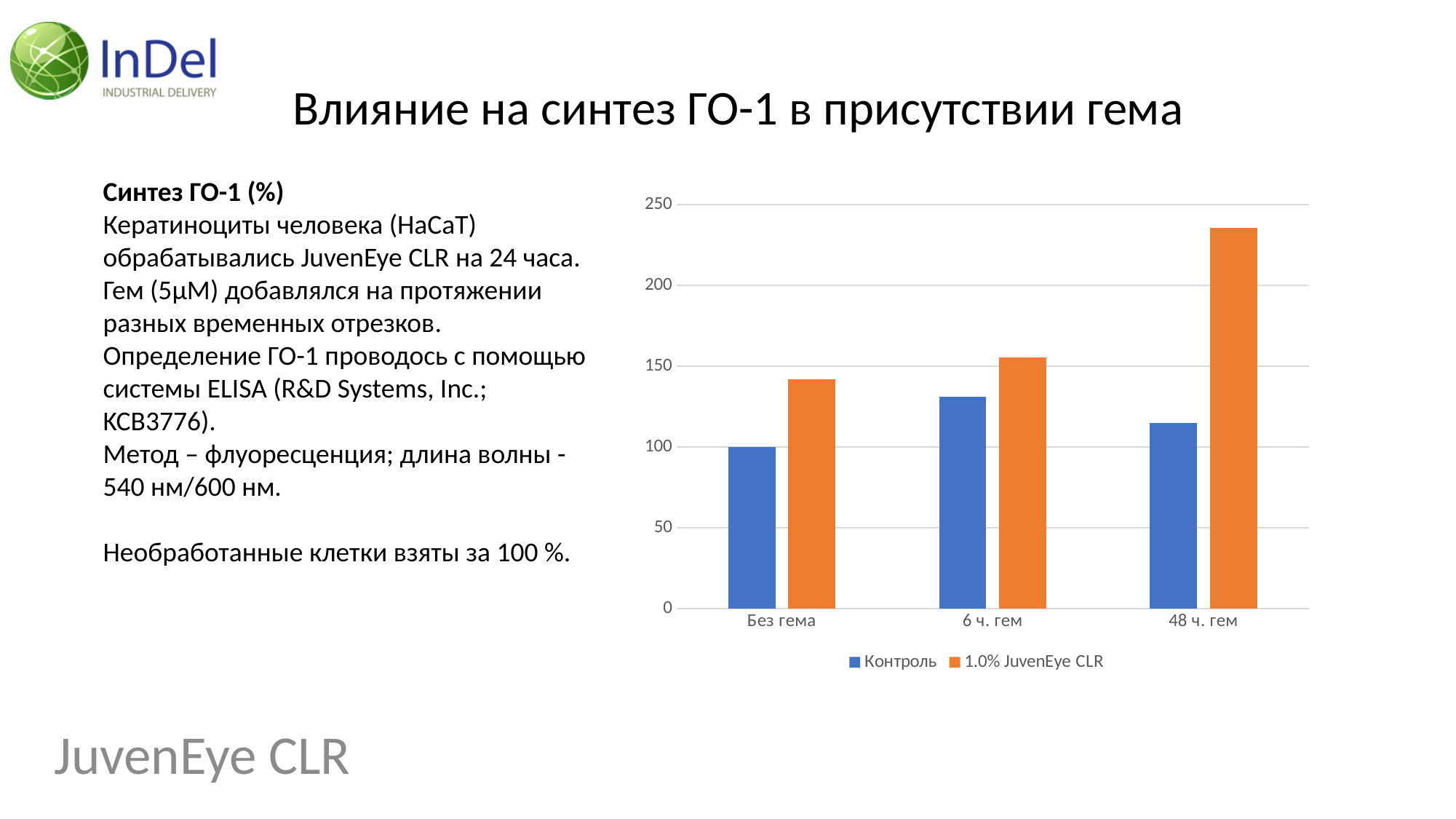
What kind of chart is shown on the slide? Bar chart Is the value for 1.0% JuvenEye CLR at 48 ч. гем greater or less than 200? greater Which colour represents the Контроль series in the chart? Blue Is the value for 1.0% JuvenEye CLR at Без гема greater or less than 150? less For which category is the Контроль bar the lowest? Без гема How many series does the chart legend list? 2 Do the 1.0% JuvenEye CLR values rise or fall from Без гема to 48 ч. гем? Rise What is the value of Контроль for the category Без гема? 100 At 48 ч. гем, which series has the larger value, Контроль or 1.0% JuvenEye CLR? 1.0% JuvenEye CLR How many categories are shown on the x axis of the chart? 3 Is the value for Контроль at 6 ч. гем greater or less than 100? greater For which category is the 1.0% JuvenEye CLR bar the highest? 48 ч. гем